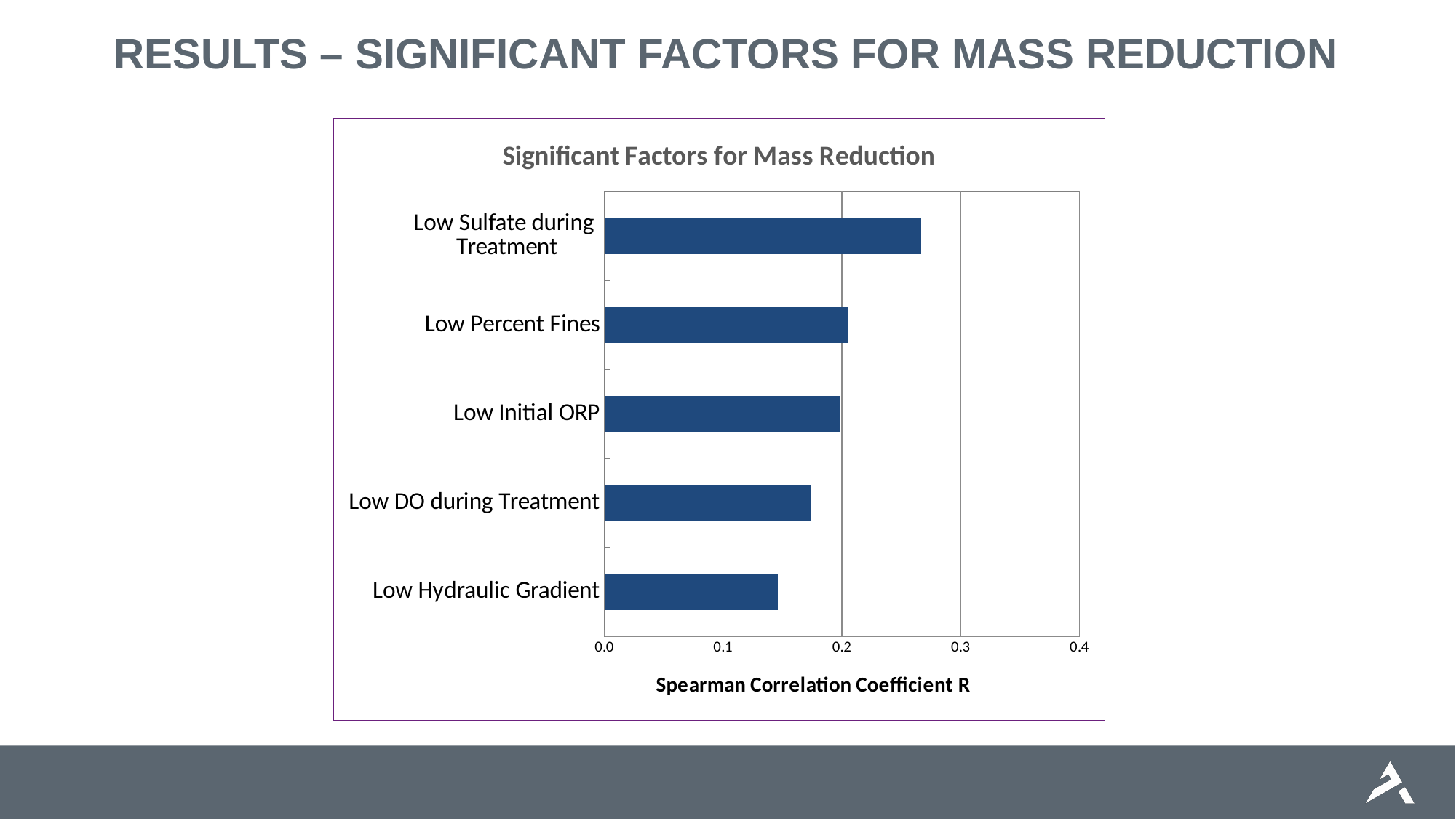
What is the label of the horizontal axis of the chart? Spearman Correlation Coefficient R Which has a larger Spearman Correlation Coefficient R: Low DO during Treatment or Low Hydraulic Gradient? Low DO during Treatment How many factors (categories) are plotted in the chart? 5 What kind of chart is shown on the slide? Bar chart Is the value for Low DO during Treatment greater or less than 0.2? less Which has a larger Spearman Correlation Coefficient R: Low Sulfate during Treatment or Low DO during Treatment? Low Sulfate during Treatment Is the value for Low Hydraulic Gradient greater or less than 0.1? greater Which factor has the lowest Spearman Correlation Coefficient R? Low Hydraulic Gradient What is the title of the chart? Significant Factors for Mass Reduction Which factor has the highest Spearman Correlation Coefficient R? Low Sulfate during Treatment Is the value for Low Sulfate during Treatment greater or less than 0.3? less